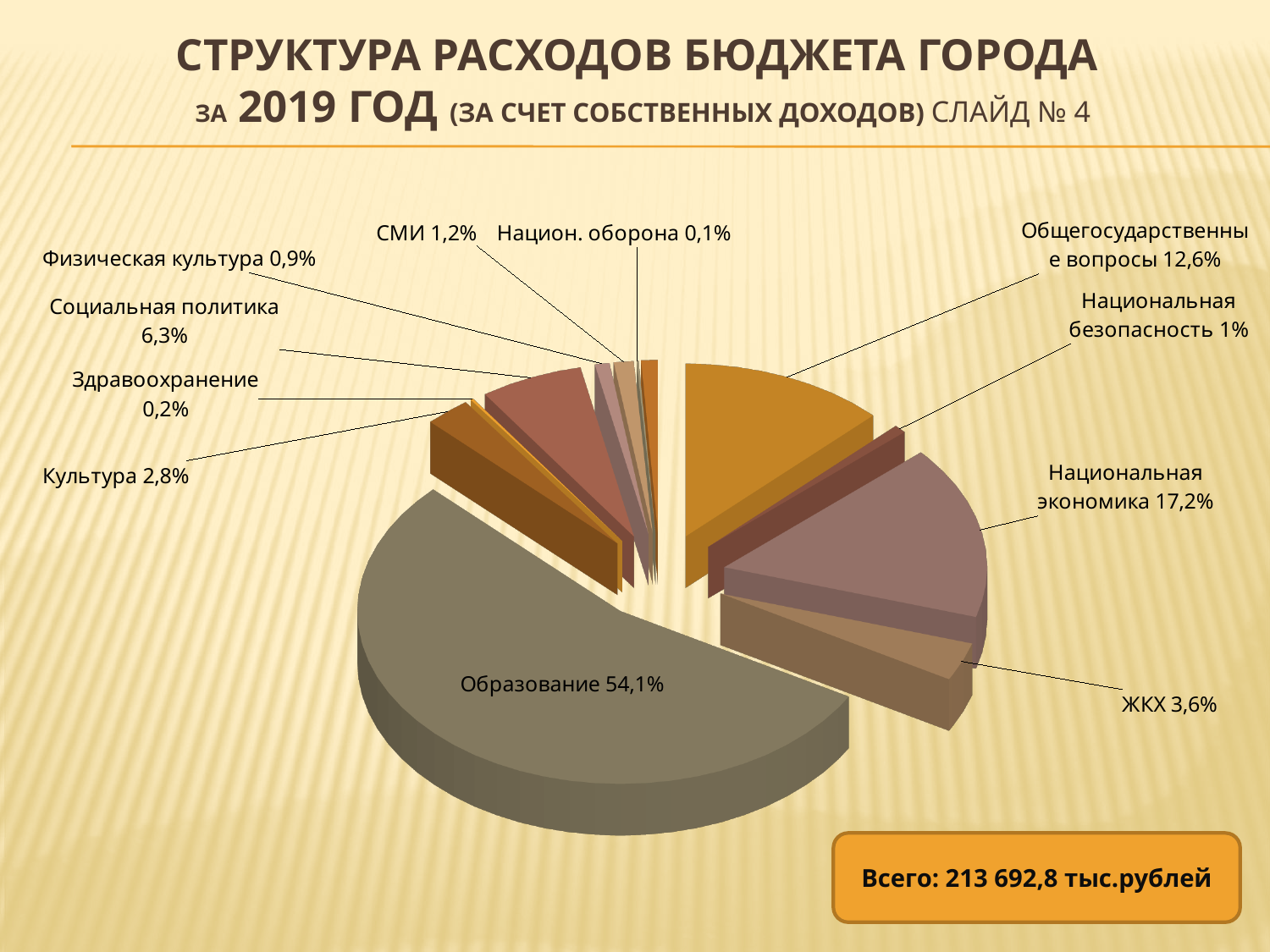
What is the value for ЖКХ? 3,6% What total amount is stated in the box at the bottom right of the slide? 213 692,8 тыс.рублей What percentage is shown for Общегосударственные вопросы? 12,6% What share of the budget expenditure goes to Образование? 54,1% Which category has the smallest share of the pie? Национ. оборона What kind of chart is shown on the slide? pie chart What is the value shown for Национальная экономика? 17,2% What percentage is shown for Социальная политика? 6,3% What is the difference between the shares of Национальная экономика and Общегосударственные вопросы? 4,6% Which category has the largest share of the pie? Образование Which is larger, the share for Культура or the share for СМИ? Культура